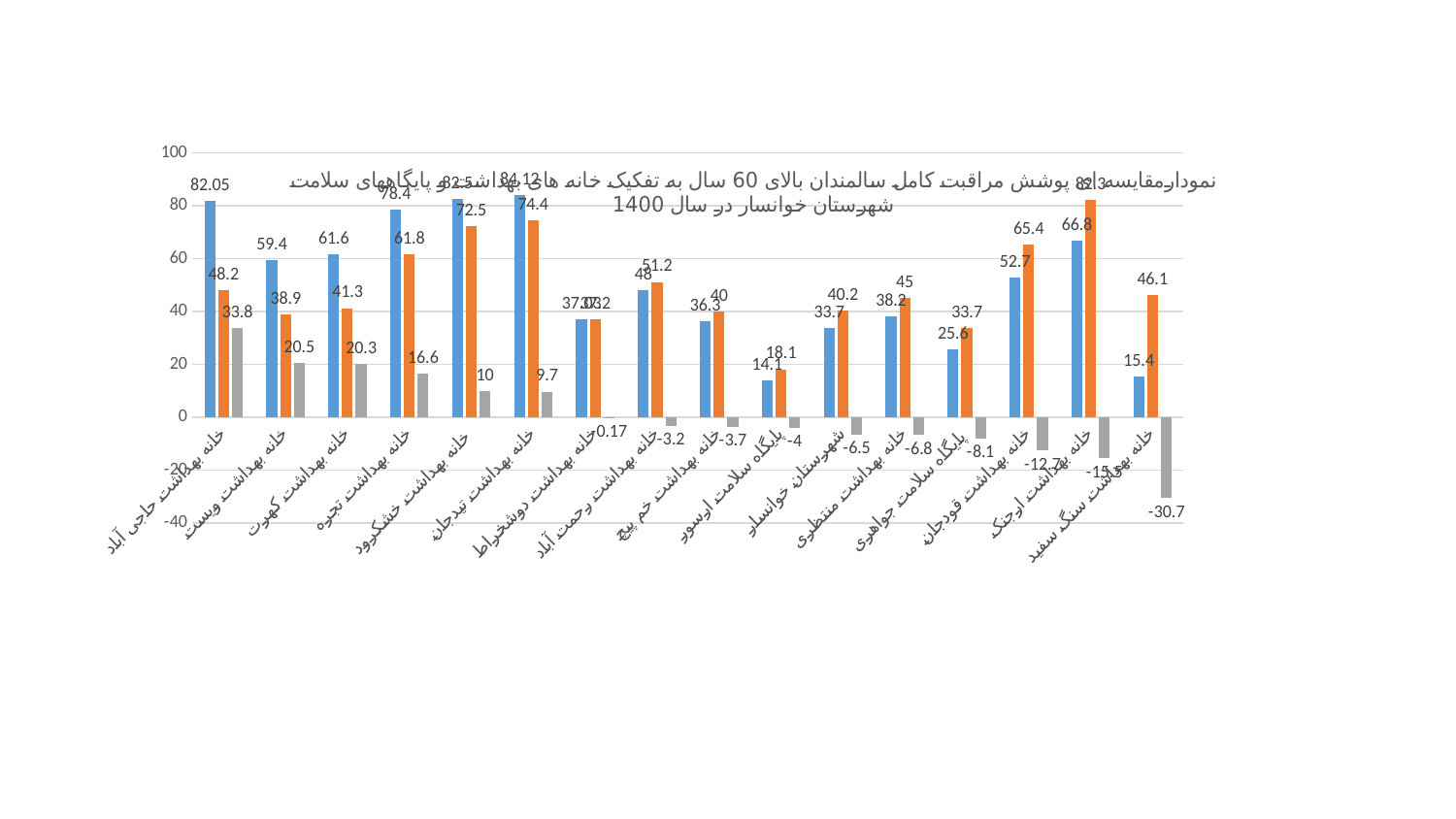
What is the difference between the blue bar (82.05) and the orange bar (48.2) for خانه بهداشت حاجی آباد? 33.85 Which category has the highest gray bar value? خانه بهداشت حاجی آباد What is the value of the blue bar for خانه بهداشت حاجی آباد? 82.05 What kind of chart is shown on the slide? bar chart Which category has the lowest gray bar value? خانه بهداشت سنگ سفید Is the value of the blue bar for خانه بهداشت خشکرود greater or less than 80? greater How many categories are shown on the x axis of the chart? 16 What is the value of the orange bar for خانه بهداشت سنگ سفید? 46.1 What is the value of the orange bar for خانه بهداشت قودجان? 65.4 What is the value of the blue bar for پایگاه سلامت جواهری? 25.6 For خانه بهداشت سنگ سفید, which is larger: the blue bar or the orange bar? the orange bar What is the value of the gray bar for خانه بهداشت سنگ سفید? -30.7